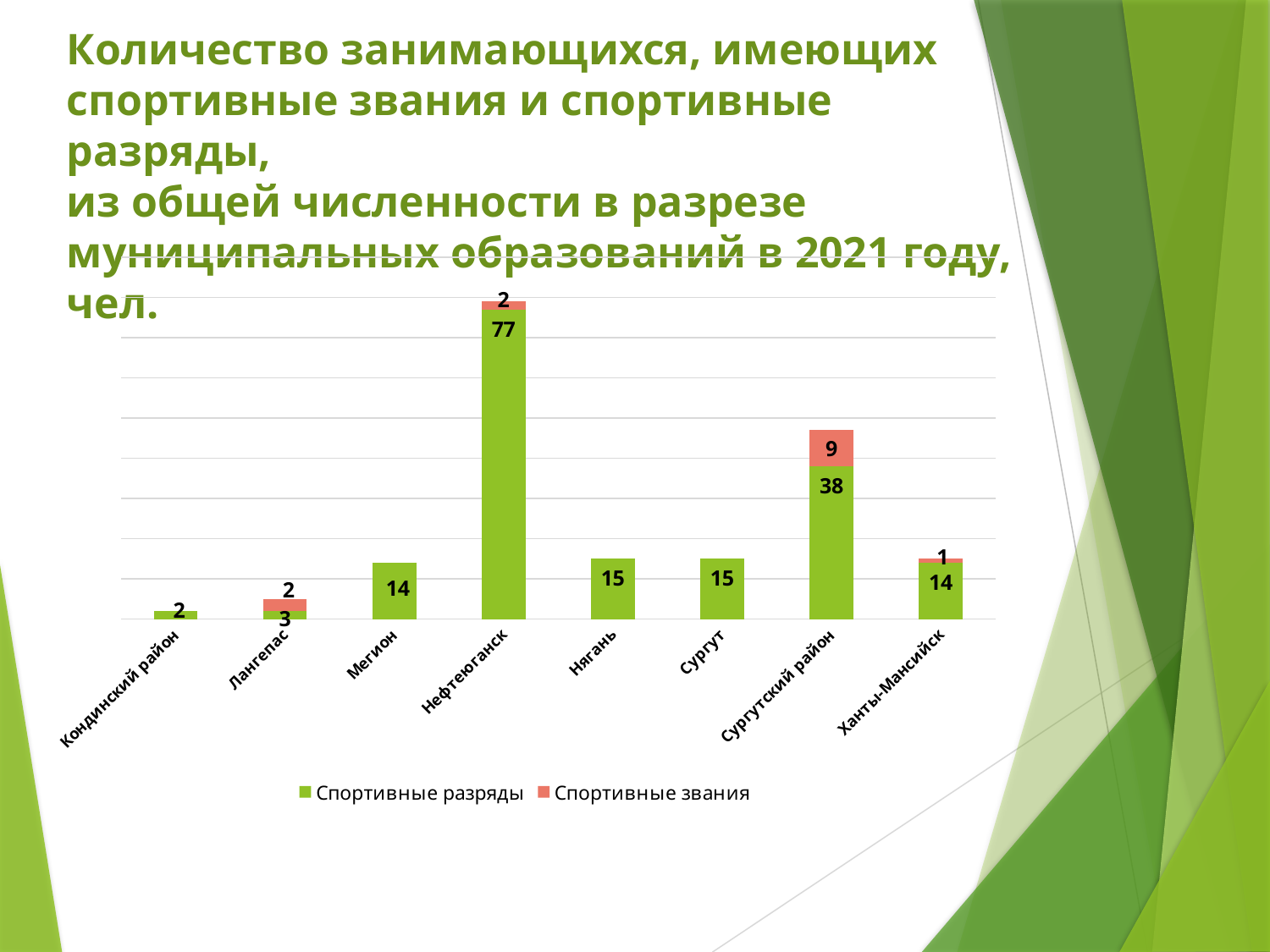
What is the difference between the Спортивные разряды values for Нефтеюганск and Сургутский район? 39 What is the value of Спортивные разряды for Нефтеюганск? 77 What is the total of the stacked bar for Сургутский район? 47 How many series does the legend list? 2 Which municipality has the lowest value of Спортивные разряды? Кондинский район and Лангепас (both 2) What is the value of Спортивные звания for Сургутский район? 9 How many municipalities are shown on the x axis? 8 What is the total of the stacked bar for Лангепас? 5 Which municipality has the highest value of Спортивные разряды? Нефтеюганск Which is larger: the Спортивные разряды value for Мегион or for Нягань? Нягань What is the value of Спортивные звания for Ханты-Мансийск? 1 What is the value of Спортивные разряды for Лангепас? 2